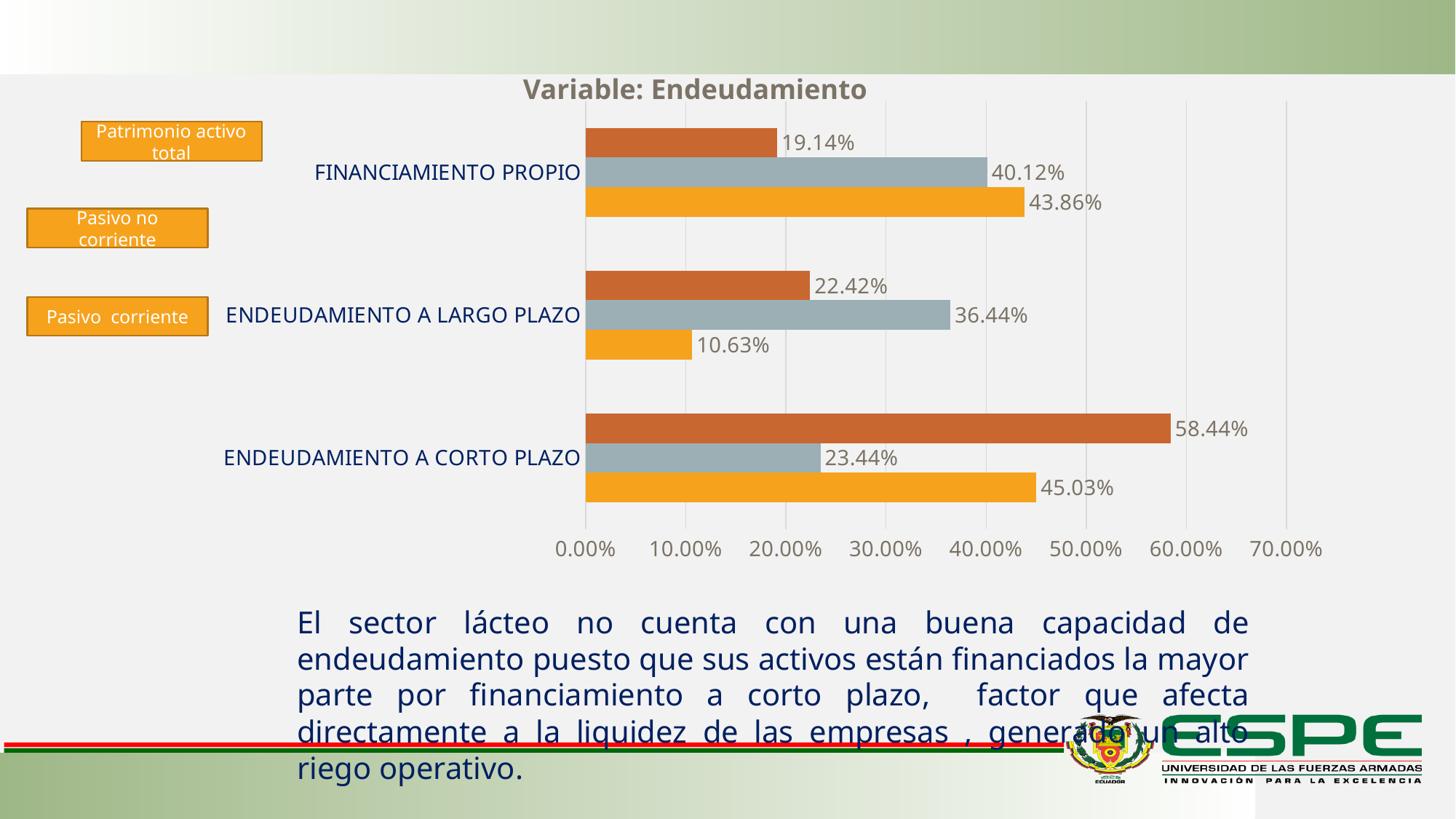
What is the value of the dark orange (top) bar for ENDEUDAMIENTO A CORTO PLAZO? 58.44% Which bar has the lowest value in the whole chart? The yellow bar for ENDEUDAMIENTO A LARGO PLAZO (10.63%) What is the value of the yellow (bottom) bar for ENDEUDAMIENTO A LARGO PLAZO? 10.63% What is the title of the chart? Variable: Endeudamiento What is the value of the gray (middle) bar for ENDEUDAMIENTO A CORTO PLAZO? 23.44% Which bar has the highest value in the whole chart? The dark orange bar for ENDEUDAMIENTO A CORTO PLAZO (58.44%) What is the value of the gray (middle) bar for FINANCIAMIENTO PROPIO? 40.12% How many categories are shown on the vertical axis of the chart? 3 For ENDEUDAMIENTO A LARGO PLAZO, which is larger: the gray bar or the dark orange bar? The gray bar (36.44%) What is the difference between the yellow bar (43.86%) and the dark orange bar (19.14%) for FINANCIAMIENTO PROPIO? 24.72% How many bars are plotted for each category in the chart? 3 What type of chart is shown on the slide? Bar chart